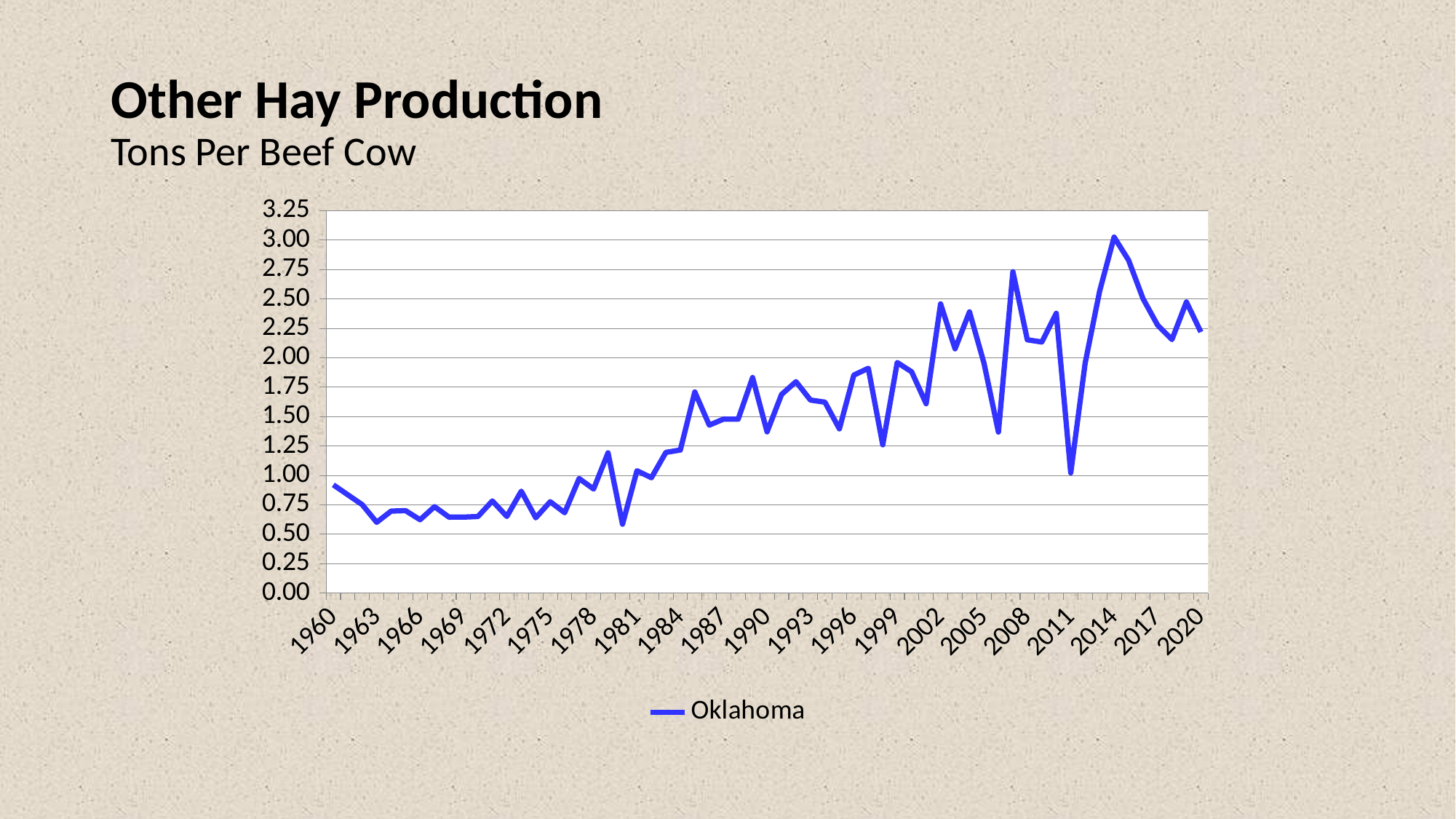
Is the value for 2014 greater or less than 2.75? greater What is the title of the chart on the slide? Other Hay Production Which year has the larger value, 2008 or 2011? 2008 What is the name of the series shown in the legend? Oklahoma Is the value for 2020 greater or less than 2.50? less Overall, do the values rise or fall from 1960 to 2020? rise In which year does the Oklahoma line reach its highest value? 2014 Which year has the larger value, 1960 or 1980? 1960 How many series does the legend list? 1 What kind of chart is shown on the slide? line chart Is the value for 1960 greater or less than 1.00? less